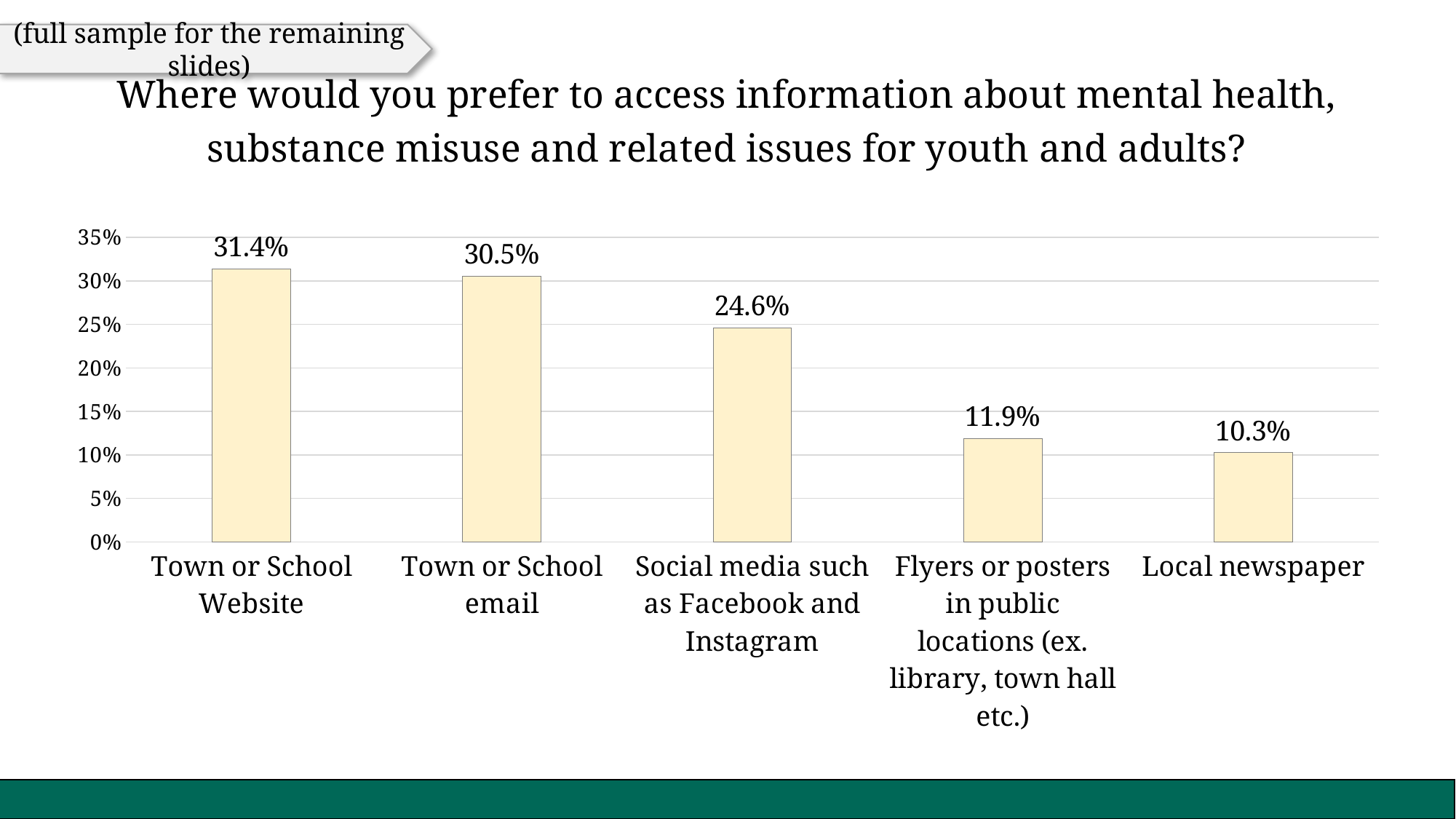
What kind of chart is shown on the slide? Bar chart Which category has the highest value? Town or School Website Do the values rise or fall from left to right along the x axis? Fall What is the difference between Town or School Website and Town or School email? 0.9% How many categories are shown on the chart? 5 What is the value for Local newspaper? 10.3% Which is larger: Flyers or posters in public locations or Local newspaper? Flyers or posters in public locations Which category has the lowest value? Local newspaper What percentage of respondents prefer the Town or School Website? 31.4% What is the difference between Social media such as Facebook and Instagram and Flyers or posters in public locations? 12.7% Is the value for Town or School email greater or less than 25%? greater What percentage prefer Social media such as Facebook and Instagram? 24.6%